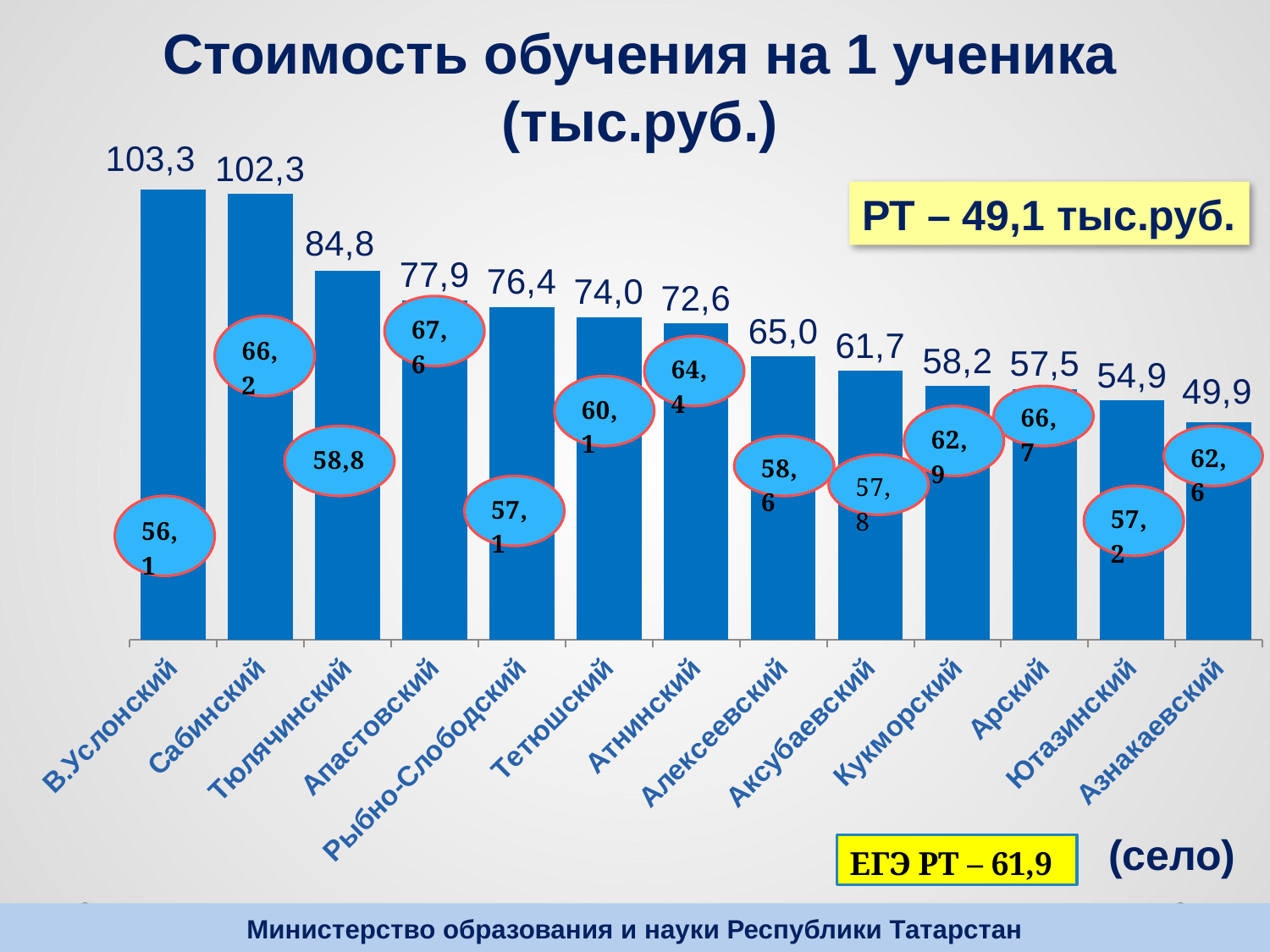
How many categories are shown on the chart? 13 What is the value for В.Услонский? 103,3 Which category has the highest value? В.Услонский What is the difference between the values for В.Услонский and Сабинский? 1,0 What is the value for Азнакаевский? 49,9 What kind of chart is shown on the slide? bar chart Do the values rise or fall from left to right along the x axis? fall What is the difference between the values for Тюлячинский and Азнакаевский? 34,9 Which is larger, the value for Алексеевский or the value for Аксубаевский? Алексеевский Which category has the lowest value? Азнакаевский What is the value for Кукморский? 58,2 What is the value for Тетюшский? 74,0